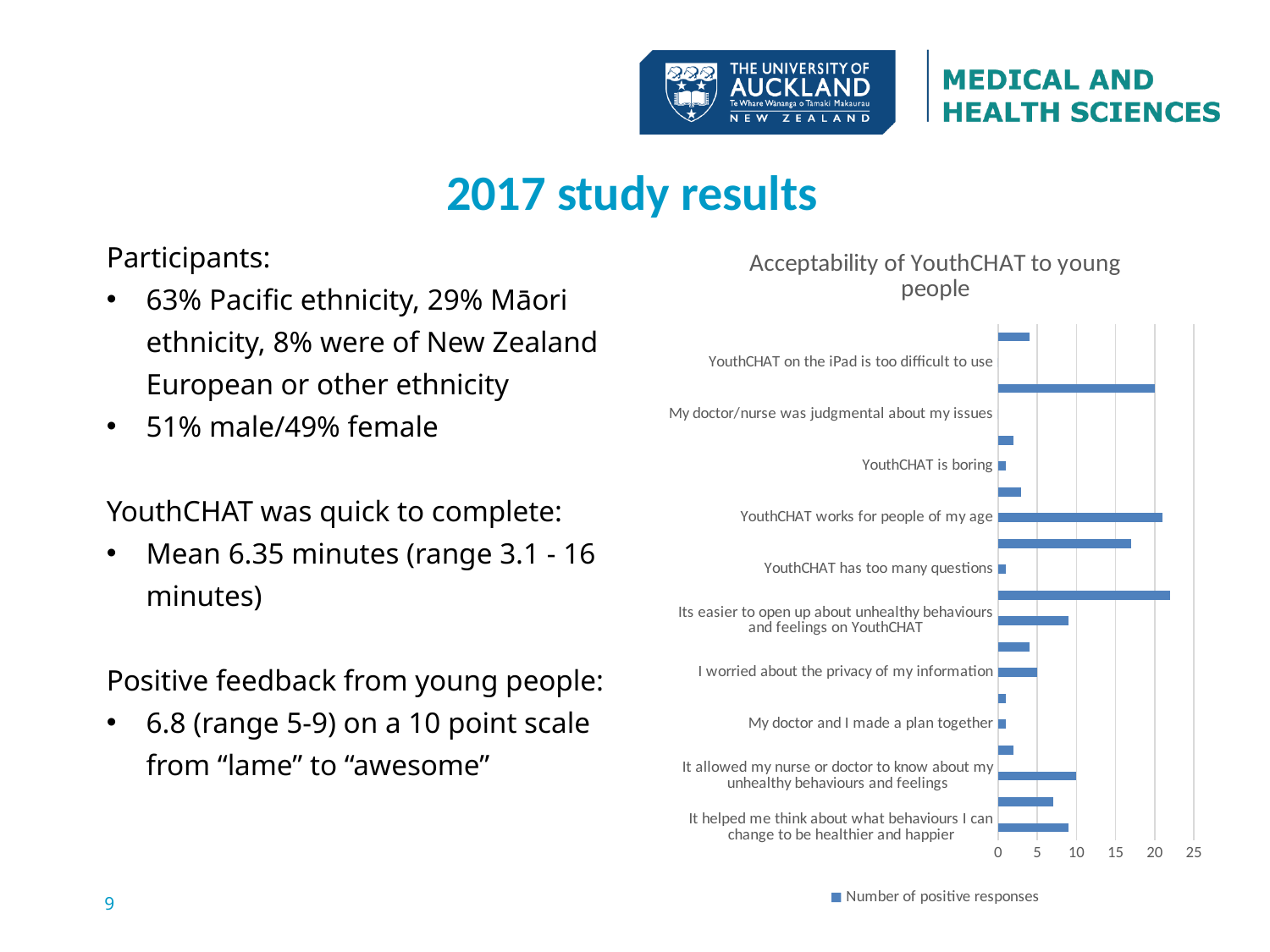
Which has the larger value: "YouthCHAT works for people of my age" or "YouthCHAT is boring"? YouthCHAT works for people of my age How many series does the chart legend list? 1 Is the value for "It helped me think about what behaviours I can change to be healthier and happier" greater or less than 5? greater What is the title of the chart? Acceptability of YouthCHAT to young people Is the value for "YouthCHAT works for people of my age" greater or less than 15? greater What series name is shown in the chart legend? Number of positive responses Which has the larger value: "Its easier to open up about unhealthy behaviours and feelings on YouthCHAT" or "YouthCHAT has too many questions"? Its easier to open up about unhealthy behaviours and feelings on YouthCHAT What kind of chart is shown on the slide? Bar chart Is the value for "YouthCHAT has too many questions" greater or less than 5? less